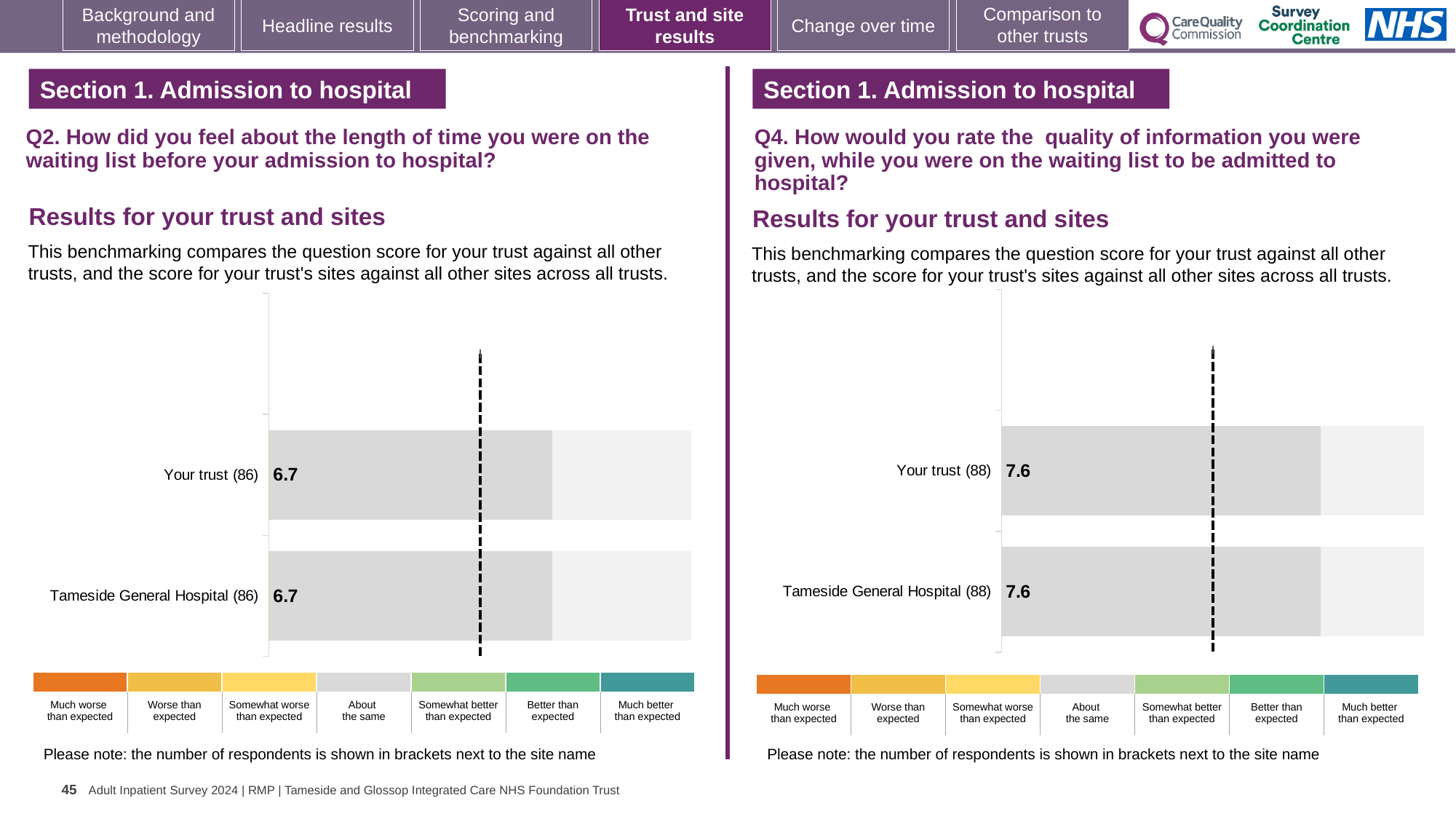
On the left chart (Q2), what is the score for Tameside General Hospital? 6.7 On the right chart (Q4), what is the difference between the score for Your trust and the score for Tameside General Hospital? 0 On the left chart (Q2), how many respondents are shown in brackets for Your trust? 86 On the left chart (Q2), what is the score for Your trust? 6.7 On the left chart (Q2), what is the difference between the score for Your trust and the score for Tameside General Hospital? 0 Is the score for Your trust on the right chart (Q4) larger or smaller than the score for Your trust on the left chart (Q2)? Larger On the left chart (Q2), how many bars are plotted? 2 What kind of chart is shown on the left (Q2)? Bar chart On the right chart (Q4), how many bars are plotted? 2 On the right chart (Q4), what is the score for Tameside General Hospital? 7.6 On the right chart (Q4), how many respondents are shown in brackets for Tameside General Hospital? 88 On the right chart (Q4), what is the score for Your trust? 7.6